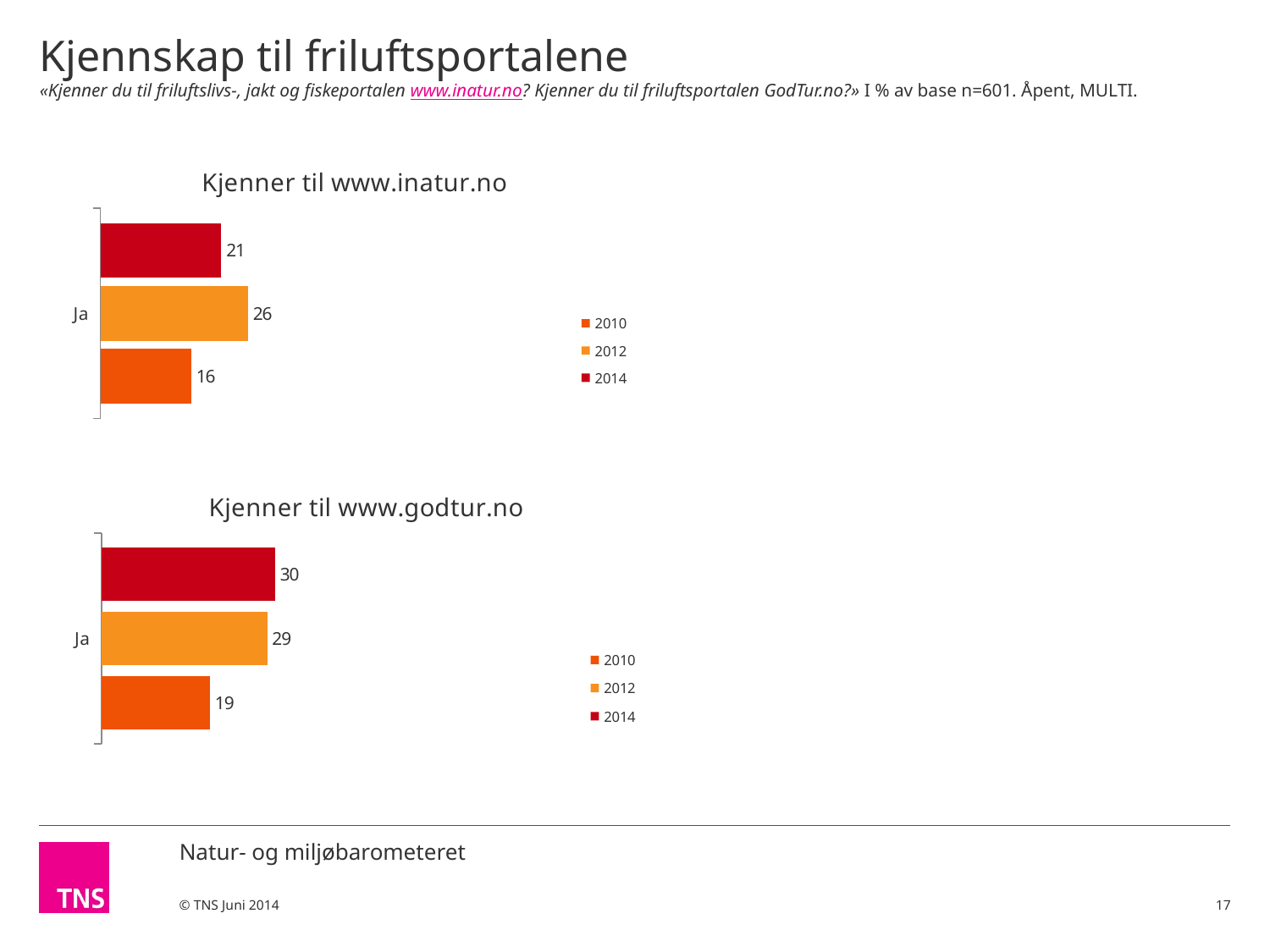
In the chart 'Kjenner til www.inatur.no', what is the value for 2012? 26 In the chart 'Kjenner til www.inatur.no', what is the value for 2014? 21 In the chart 'Kjenner til www.inatur.no', what is the difference between the 2012 and 2010 values? 10 What kind of chart is 'Kjenner til www.inatur.no'? Bar chart In the chart 'Kjenner til www.inatur.no', which year has the highest value? 2012 In the chart 'Kjenner til www.godtur.no', what is the value for 2010? 19 In the chart 'Kjenner til www.godtur.no', what is the difference between the 2014 and 2010 values? 11 In the chart 'Kjenner til www.inatur.no', which is larger, the value for 2014 or the value for 2010? 2014 In the chart 'Kjenner til www.inatur.no', what is the value for 2010? 16 In the chart 'Kjenner til www.godtur.no', what is the value for 2014? 30 How many series does the legend of the chart 'Kjenner til www.godtur.no' list? 3 In the chart 'Kjenner til www.godtur.no', which year has the lowest value? 2010